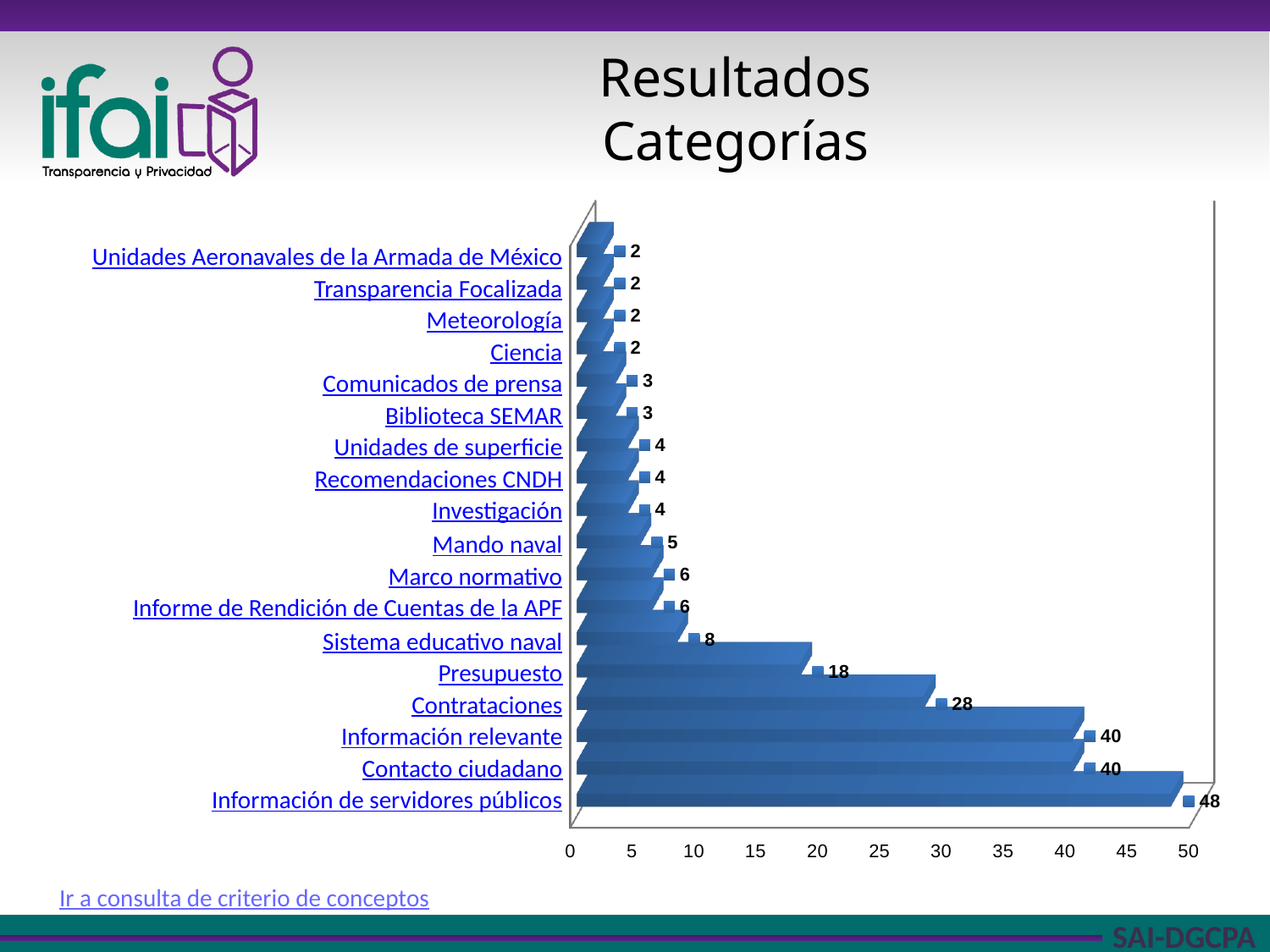
What is the difference between the values for Contrataciones and Presupuesto? 10 What is the value for Mando naval? 5 How many categories are shown in the chart? 18 Which category has the highest value? Información de servidores públicos What is the value for Sistema educativo naval? 8 What is the difference between the values for Información de servidores públicos and Contacto ciudadano? 8 What is the value for Información de servidores públicos? 48 What is the value for Contrataciones? 28 Is the value for Información relevante greater or less than 35? greater What kind of chart is shown on the slide? Bar chart Which is larger, the value for Presupuesto or the value for Sistema educativo naval? Presupuesto What is the value for Presupuesto? 18